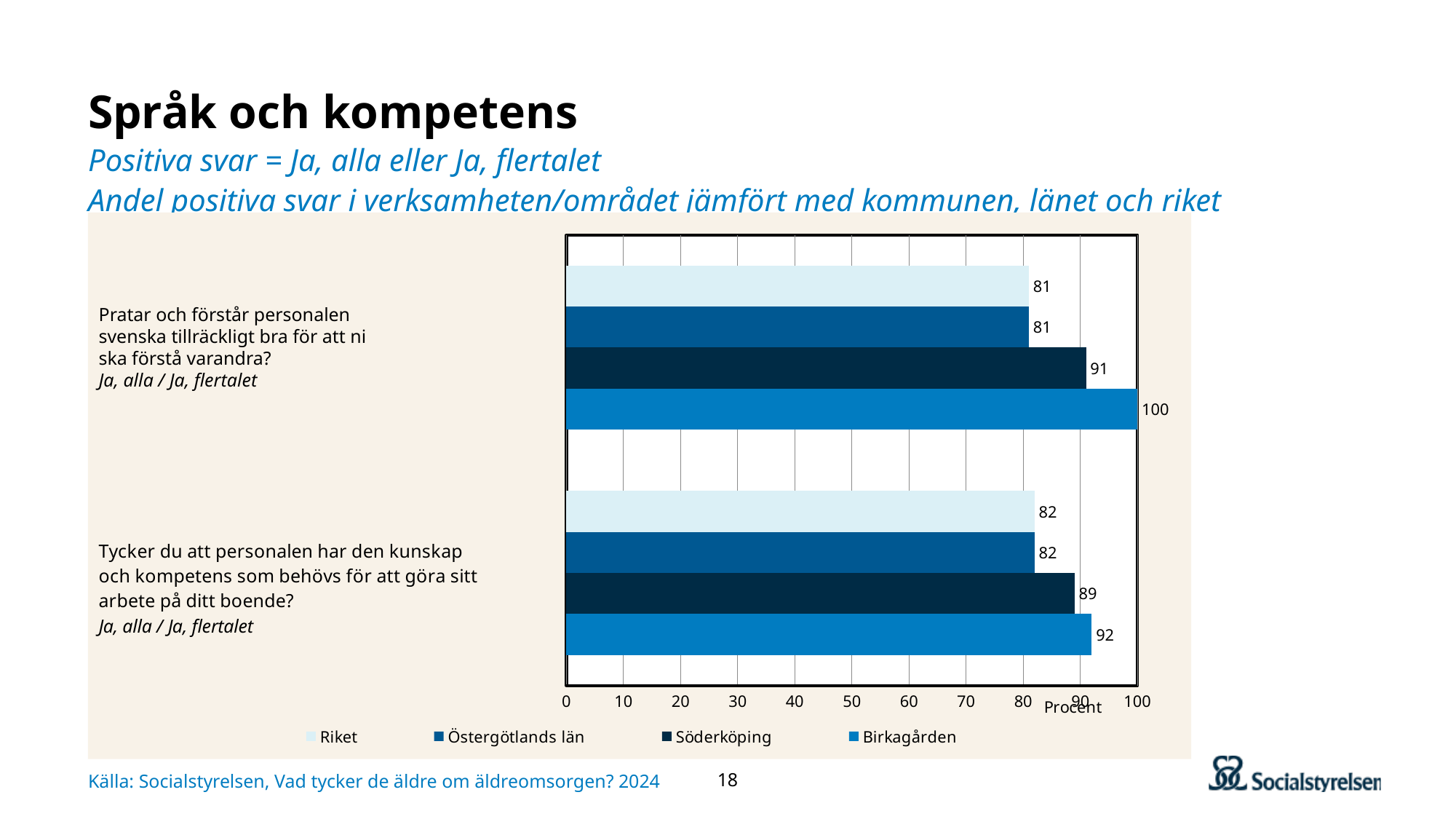
What is the label of the x axis? Procent What kind of chart is shown on the slide? Bar chart What is the value for Söderköping on the question "Tycker du att personalen har den kunskap och kompetens som behövs för att göra sitt arbete på ditt boende?"? 89 How many series does the legend list? 4 What is the value for Riket on the question "Tycker du att personalen har den kunskap och kompetens som behövs för att göra sitt arbete på ditt boende?"? 82 What is the value for Birkagården on the question "Pratar och förstår personalen svenska tillräckligt bra för att ni ska förstå varandra?"? 100 Which series has the lowest value on the question "Tycker du att personalen har den kunskap och kompetens som behövs för att göra sitt arbete på ditt boende?"? Riket and Östergötlands län (both 82) What is the value for Östergötlands län on the question "Pratar och förstår personalen svenska tillräckligt bra för att ni ska förstå varandra?"? 81 What is the difference between Birkagården and Söderköping on the question "Pratar och förstår personalen svenska tillräckligt bra för att ni ska förstå varandra?"? 9 What is the difference between Birkagården and Riket on the question "Tycker du att personalen har den kunskap och kompetens som behövs för att göra sitt arbete på ditt boende?"? 10 Which series has the highest value on the question "Pratar och förstår personalen svenska tillräckligt bra för att ni ska förstå varandra?"? Birkagården Which is larger: Söderköping's value on the Swedish-language question or Söderköping's value on the knowledge and competence question? The Swedish-language question (91)